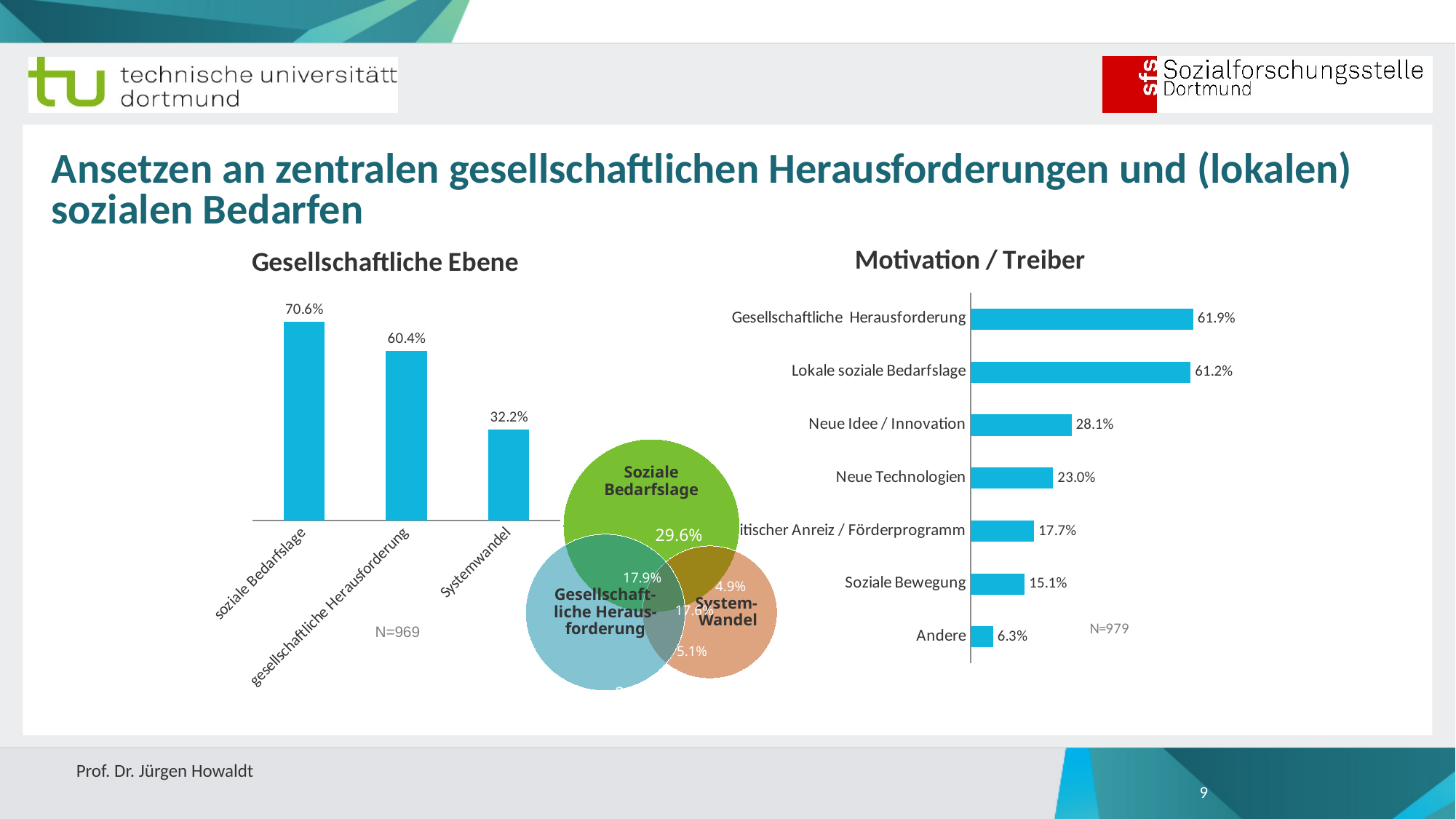
In the 'Motivation / Treiber' chart, what is the difference between Gesellschaftliche Herausforderung and Lokale soziale Bedarfslage? 0.7 percentage points In the 'Motivation / Treiber' chart, which is larger: Neue Technologien or Soziale Bewegung? Neue Technologien In the 'Gesellschaftliche Ebene' chart, which category has the lowest value? Systemwandel In the 'Gesellschaftliche Ebene' chart, what is the value for Systemwandel? 32.2% In the 'Motivation / Treiber' chart, what is the value for Neue Idee / Innovation? 28.1% What kind of chart is the 'Motivation / Treiber' chart? Bar chart How many categories are shown in the 'Motivation / Treiber' chart? 7 In the 'Motivation / Treiber' chart, what is the value for Andere? 6.3% How many categories are shown in the 'Gesellschaftliche Ebene' chart? 3 In the 'Gesellschaftliche Ebene' chart, what is the value for soziale Bedarfslage? 70.6% In the 'Motivation / Treiber' chart, which category has the highest value? Gesellschaftliche Herausforderung In the 'Gesellschaftliche Ebene' chart, what is the difference between soziale Bedarfslage and gesellschaftliche Herausforderung? 10.2 percentage points